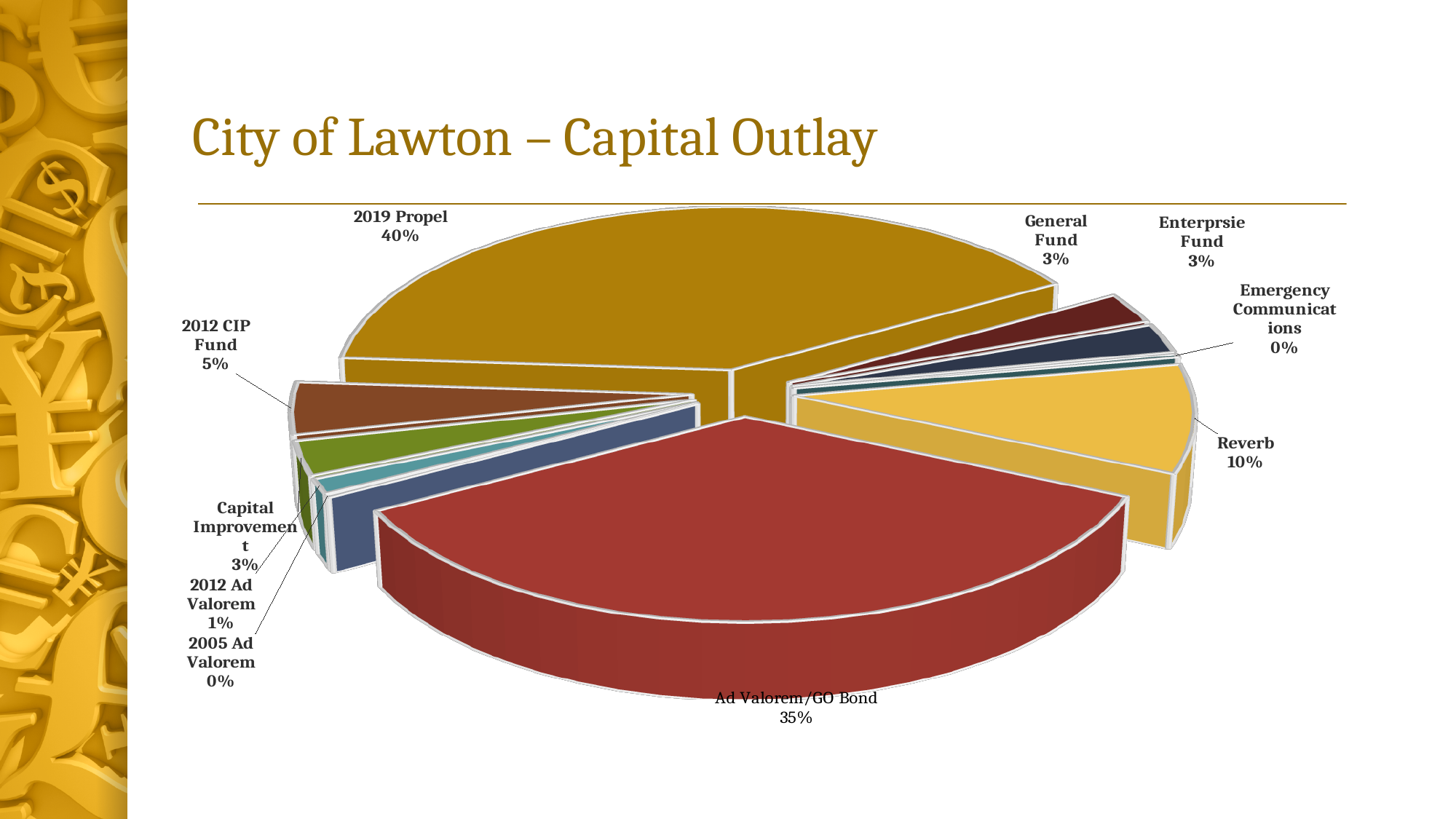
How many categories are labelled on the pie chart? 10 What percentage is shown for Reverb? 10% What is the value shown for the 2012 CIP Fund slice? 5% What percentage is shown for 2012 Ad Valorem? 1% What percentage is shown for Emergency Communications? 0% What is the value shown for Ad Valorem/GO Bond? 35% Which is larger, the share for Reverb or the share for 2012 CIP Fund? Reverb What type of chart is shown on the slide? Pie chart Which category has the largest share of the pie? 2019 Propel What is the title of the slide containing the pie chart? City of Lawton – Capital Outlay What share of the pie does 2019 Propel represent? 40% What is the difference in percentage points between 2019 Propel and Ad Valorem/GO Bond? 5